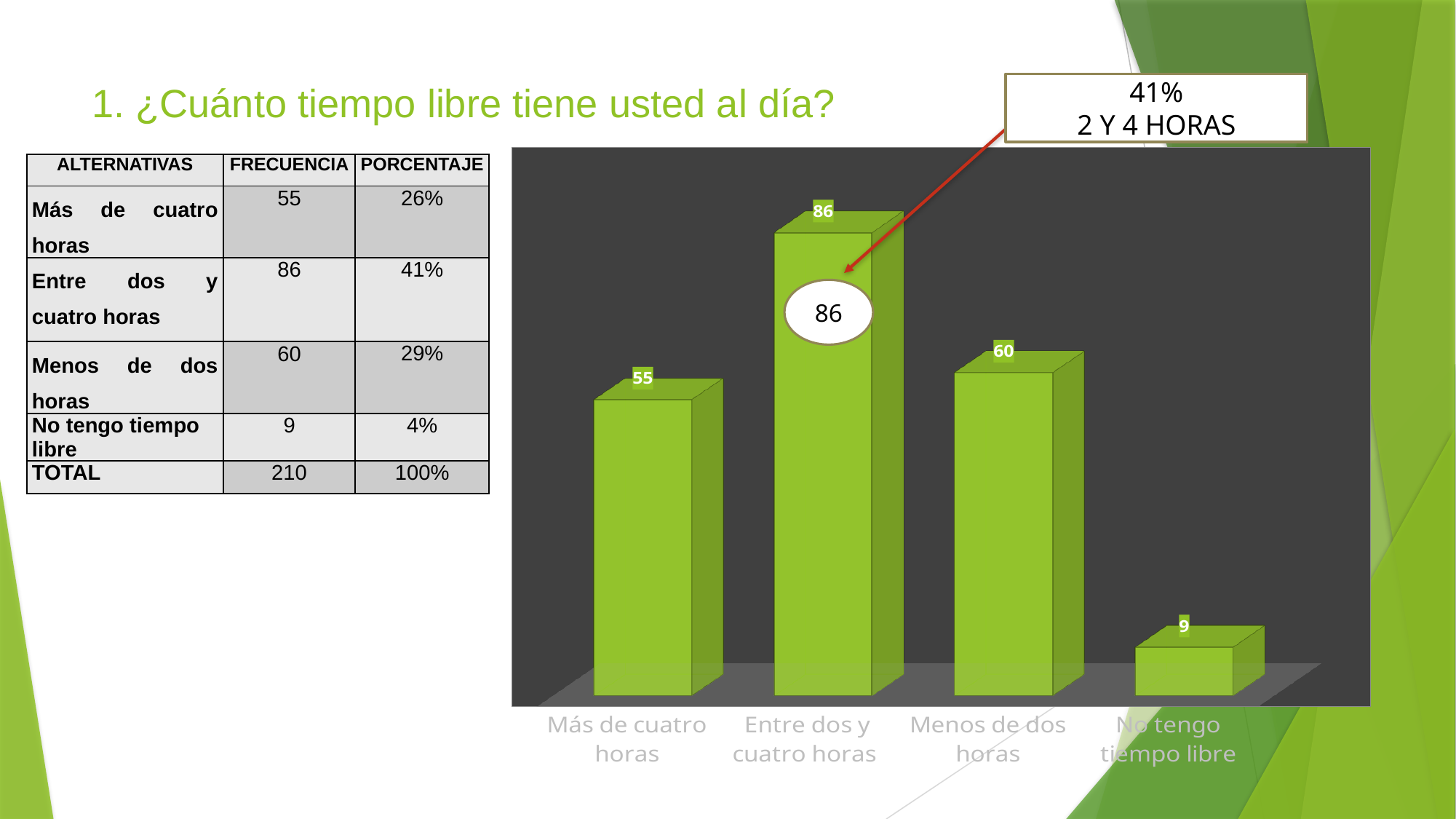
What is the value for 'Entre dos y cuatro horas'? 86 What is the difference between the values for 'Menos de dos horas' and 'Más de cuatro horas'? 5 How many categories are shown in the chart? 4 What kind of chart is shown on the slide? Bar chart What is the value for 'Más de cuatro horas'? 55 Which is larger, the value for 'Más de cuatro horas' or the value for 'Menos de dos horas'? Menos de dos horas What percentage is shown in the callout box pointing to the tallest bar? 41% What is the value for 'Menos de dos horas'? 60 What is the difference between the values for 'Entre dos y cuatro horas' and 'Menos de dos horas'? 26 Which category has the highest value? Entre dos y cuatro horas Which category has the lowest value? No tengo tiempo libre What is the value for 'No tengo tiempo libre'? 9